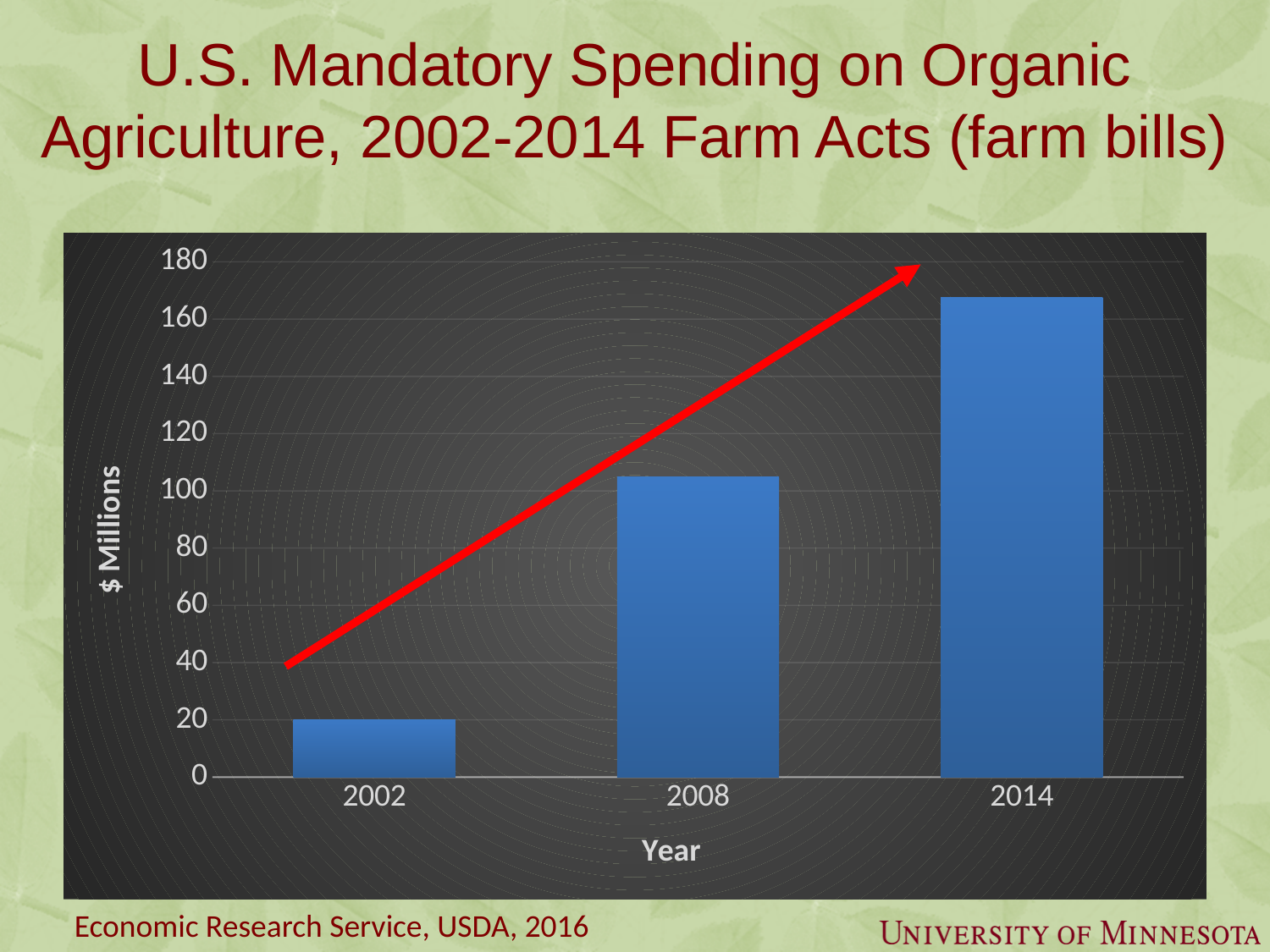
How many years are shown on the x axis of the chart? 3 Is the value for 2008 greater or less than 100? greater What is the label on the vertical axis of the chart? $ Millions Is the value for 2002 greater or less than 40? less Is the value for 2014 greater or less than 180? less What is the label on the horizontal axis of the chart? Year Which year has the lowest mandatory spending on organic agriculture? 2002 Do the values rise or fall from 2002 to 2014? Rise Which year has the highest mandatory spending on organic agriculture? 2014 What kind of chart is shown on the slide? Bar chart Which year has higher spending, 2008 or 2014? 2014